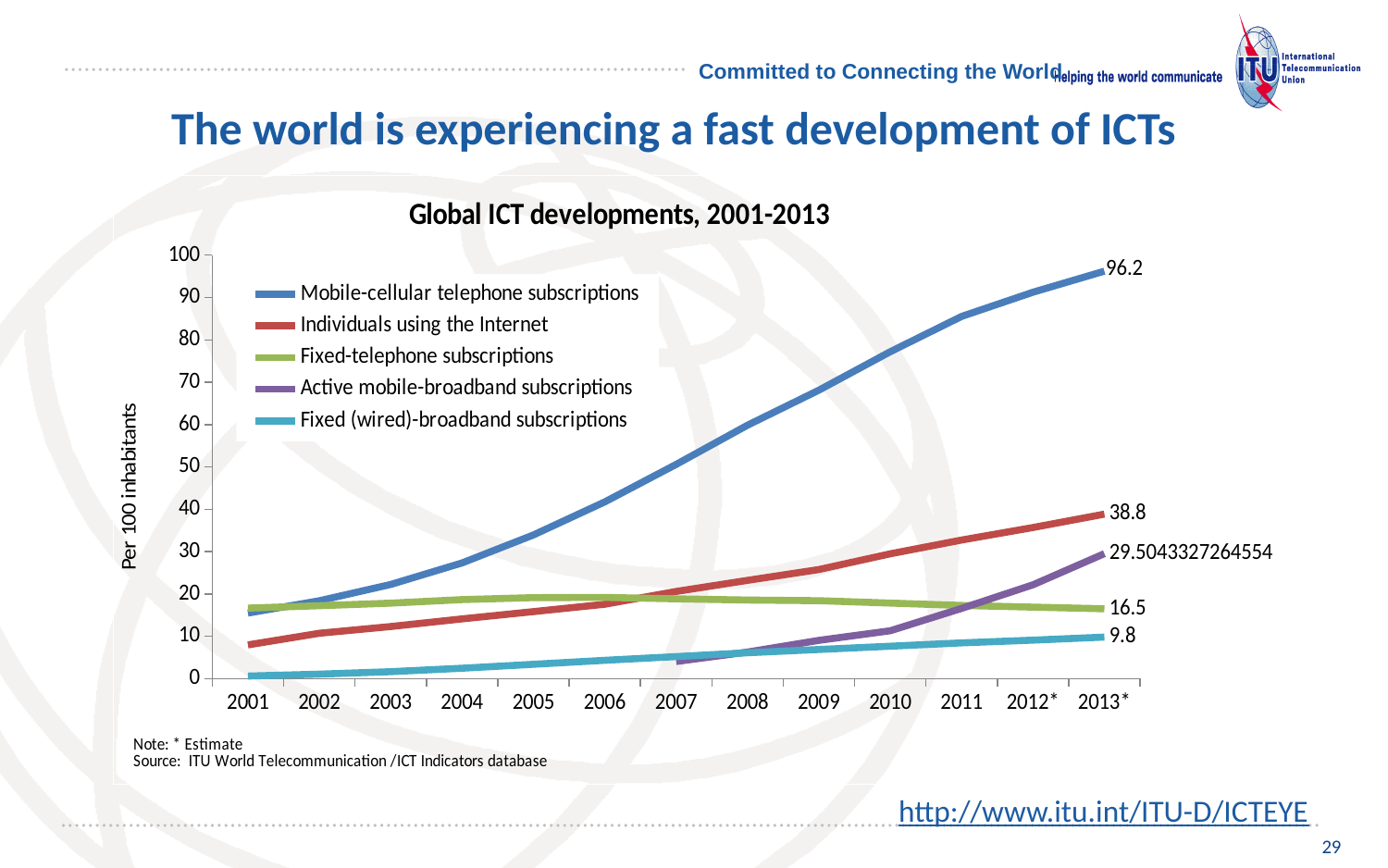
What is the value for Fixed (wired)-broadband subscriptions in 2013*? 9.8 What is the value for Fixed-telephone subscriptions in 2013*? 16.5 Which series has the highest value in 2013*? Mobile-cellular telephone subscriptions What is the difference between Mobile-cellular telephone subscriptions and Individuals using the Internet in 2013*? 57.4 Is the value for Mobile-cellular telephone subscriptions in 2010 greater or less than 70? greater Does the Mobile-cellular telephone subscriptions line rise or fall from 2001 to 2013*? Rise How many series does the legend list? 5 What is the value for Individuals using the Internet in 2013*? 38.8 Which series has the lowest value in 2013*? Fixed (wired)-broadband subscriptions What is the value for Mobile-cellular telephone subscriptions in 2013*? 96.2 In 2013*, which is larger: Individuals using the Internet or Fixed-telephone subscriptions? Individuals using the Internet What kind of chart is shown on the slide? Line chart